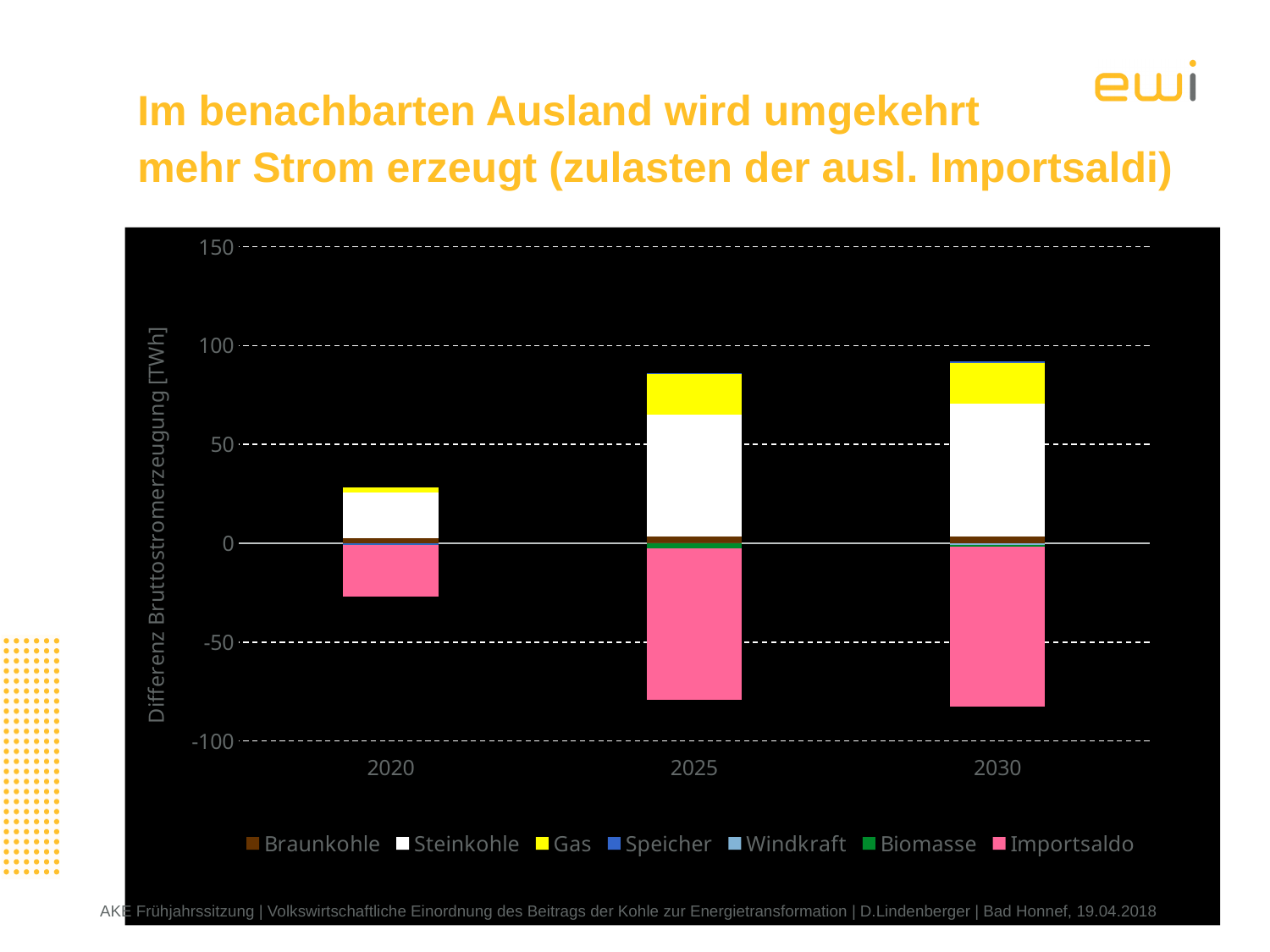
Is the Importsaldo value for 2020 greater or less than -50? greater Is the top of the positive stack for 2025 greater or less than 100? less Which series is shown in pink in the chart? Importsaldo Is the top of the positive stack for 2020 greater or less than 50? less Which year has the smallest positive stack (above zero)? 2020 What kind of chart is shown on the slide? stacked bar chart How many years are shown on the x axis of the chart? 3 Does the positive stack above zero rise or fall from 2020 to 2030? rise How many series does the chart legend list? 7 What is the label of the y axis? Differenz Bruttostromerzeugung [TWh]